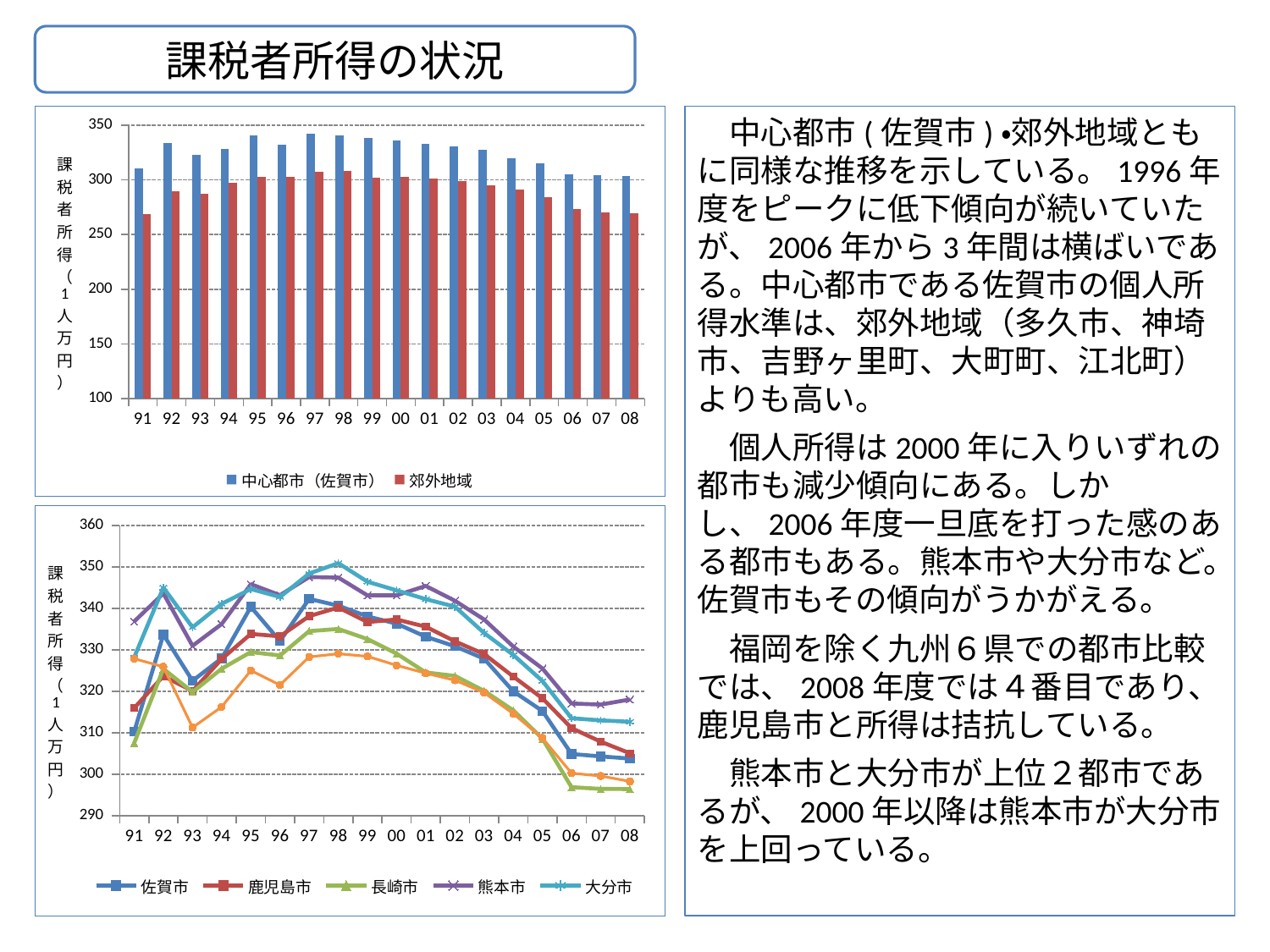
In the bottom chart, which city has the lowest value in 08? 長崎市 In the top chart, is the value for 中心都市（佐賀市） in 91 greater or less than 300? greater In the bottom chart, which city has the highest value in 08? 熊本市 In the bottom chart, how many series does the legend list? 5 In the bottom chart, is the value for 長崎市 in 06 greater or less than 300? less In the top chart, how many years are shown on the x axis? 18 In the top chart, how many series does the legend list? 2 What kind of chart is the bottom chart on the slide? line chart In the top chart, is the value for 郊外地域 in 91 greater or less than 300? less In the bottom chart, do the values for 佐賀市 rise or fall from 98 to 06? fall In the top chart, which series is higher in 08, 中心都市（佐賀市） or 郊外地域? 中心都市（佐賀市） What kind of chart is the top chart on the slide? bar chart